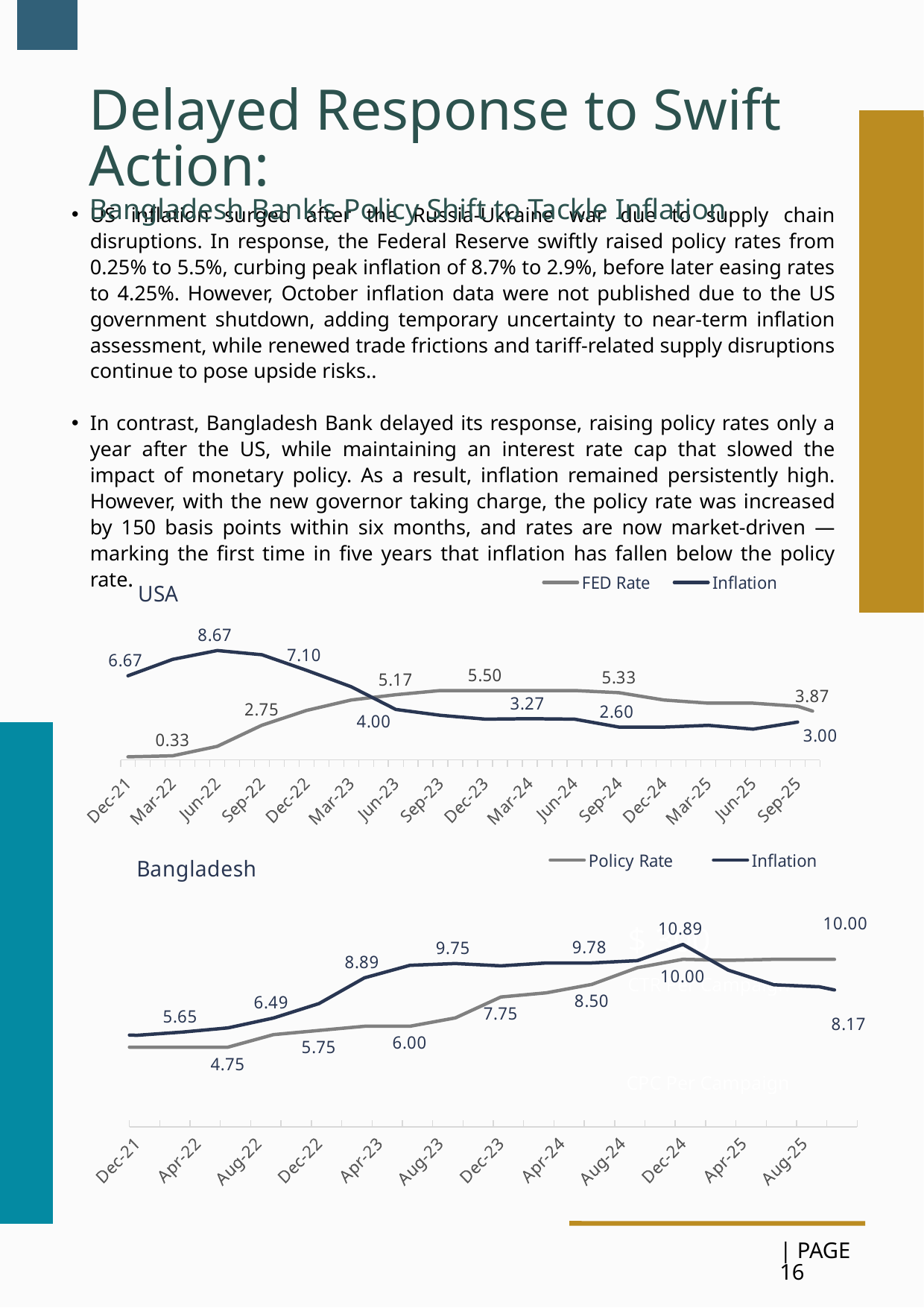
On the USA chart, does Inflation rise or fall between Jun-22 and Jun-23? fall On the USA chart, what is the difference between the peak labelled Inflation value (8.67) and the final labelled Inflation value (3.00)? 5.67 On the USA chart, what is the highest labelled Inflation value? 8.67 On the Bangladesh chart, what is the highest labelled Inflation value? 10.89 What type of chart is the USA chart? line chart On the USA chart, what is the last labelled FED Rate value at Sep-25? 3.87 What are the two series named in the legend of the Bangladesh chart? Policy Rate and Inflation On the Bangladesh chart, what is the lowest labelled Policy Rate value? 4.75 How many x-axis date labels are shown on the Bangladesh chart? 12 On the USA chart, what is the lowest labelled FED Rate value? 0.33 On the Bangladesh chart, which is larger at the end of the series: the Policy Rate (10.00) or Inflation (8.17)? Policy Rate How many series does the legend of the USA chart list? 2